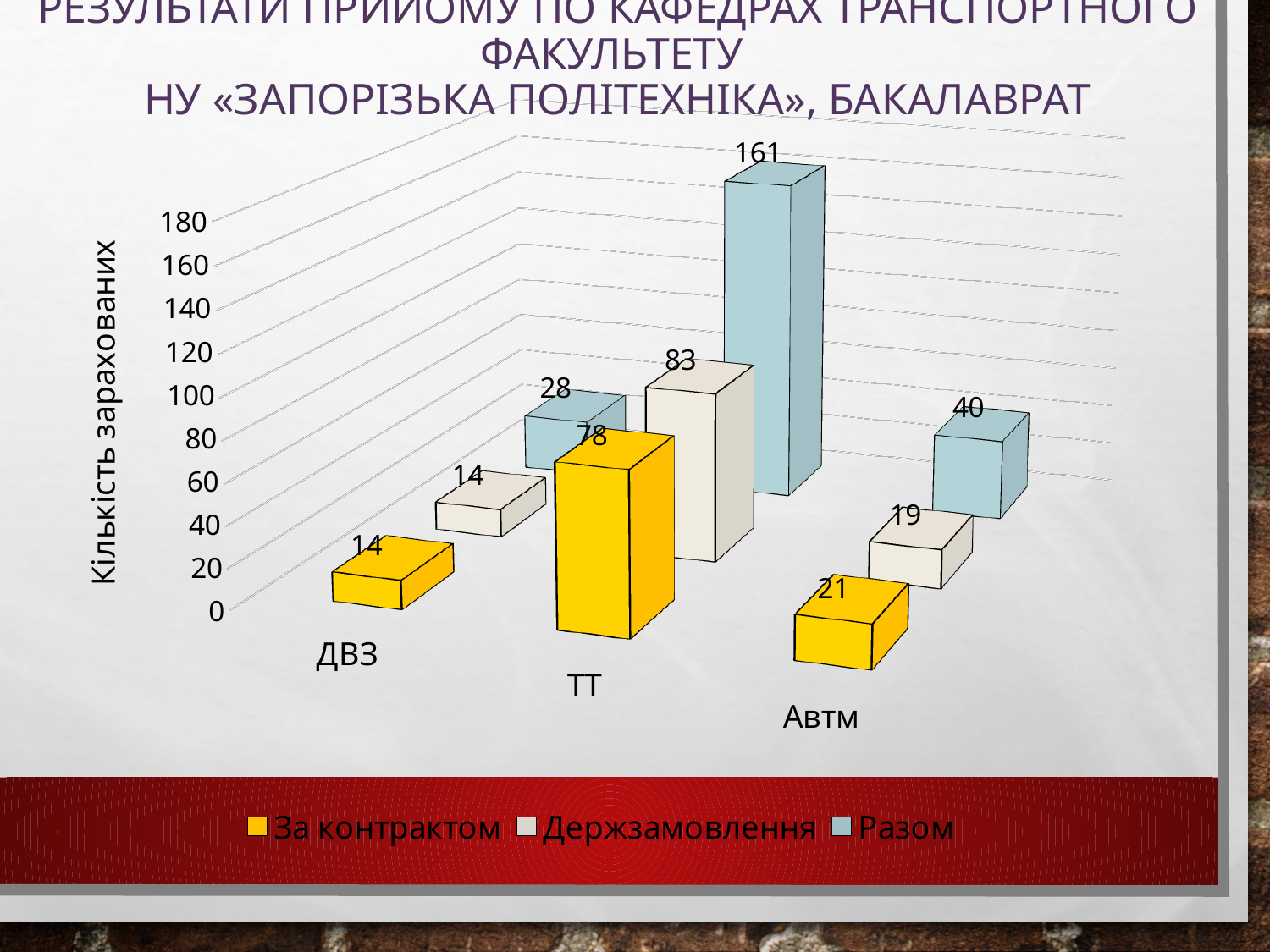
Which category has the lowest Держзамовлення value? ДВЗ What is the label of the vertical axis? Кількість зарахованих What is the value of Держзамовлення for ДВЗ? 14 How many categories are shown on the x axis? 3 What is the value of Разом for ТТ? 161 What is the difference between Держзамовлення and За контрактом for ТТ? 5 Is the Разом value for ТТ greater or less than 140? greater Which category has the highest Разом value? ТТ What kind of chart is shown on the slide? Bar chart Which is larger for Автм: За контрактом or Держзамовлення? За контрактом How many series does the legend list? 3 What is the value of За контрактом for Автм? 21